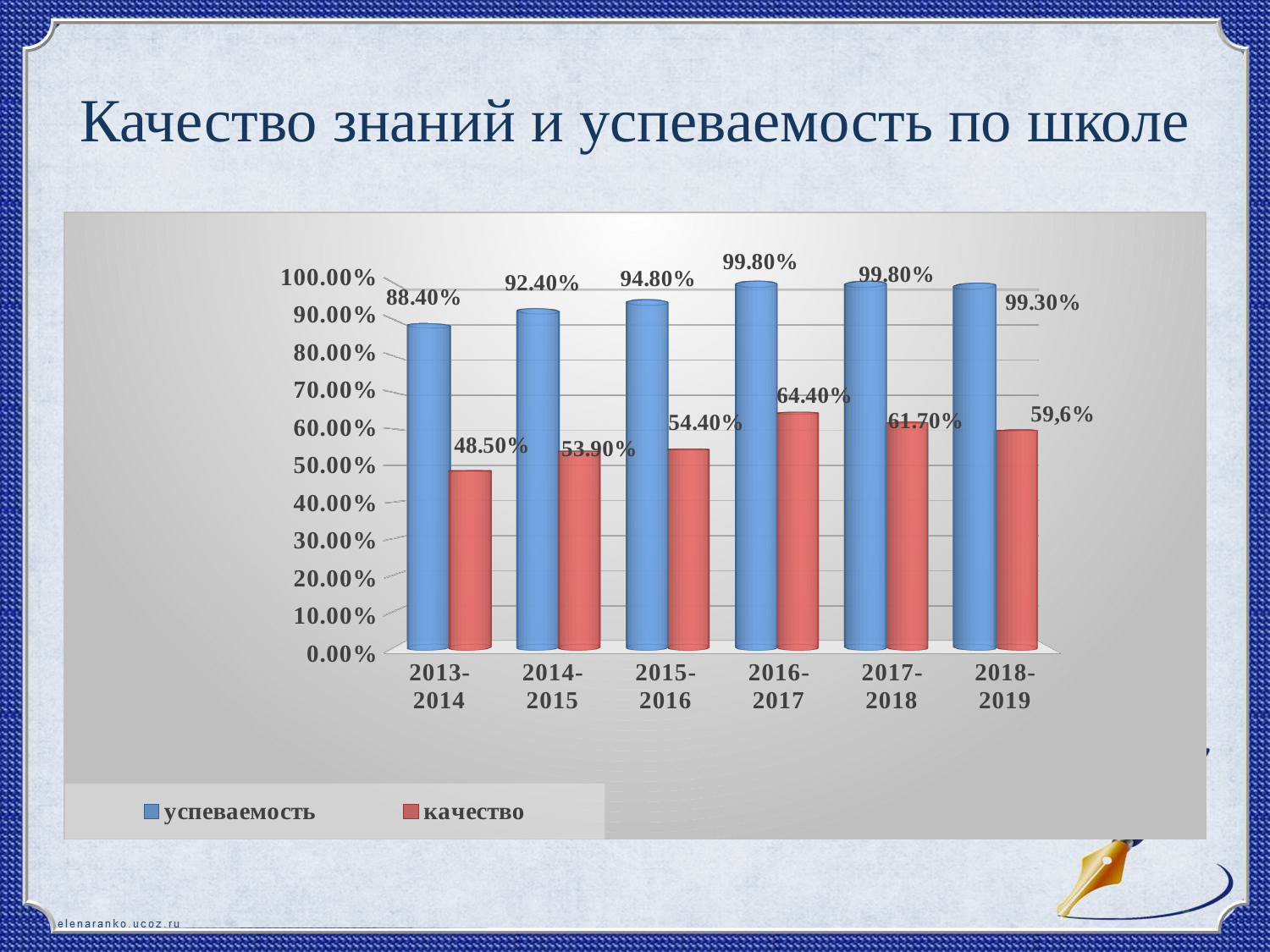
What kind of chart is shown on the slide? bar chart How many series does the legend list? 2 In which school year is качество highest? 2016-2017 Does качество rise or fall from 2013-2014 to 2016-2017? rise What is the value of качество for 2018-2019? 59,6% What is the difference between успеваемость and качество in 2016-2017? 35.40% What is the value of успеваемость for 2015-2016? 94.80% How many school years are shown on the x axis? 6 What is the value of качество for 2016-2017? 64.40% Which is larger, качество in 2017-2018 or качество in 2018-2019? 2017-2018 What is the value of успеваемость for 2013-2014? 88.40% In which school year is успеваемость lowest? 2013-2014